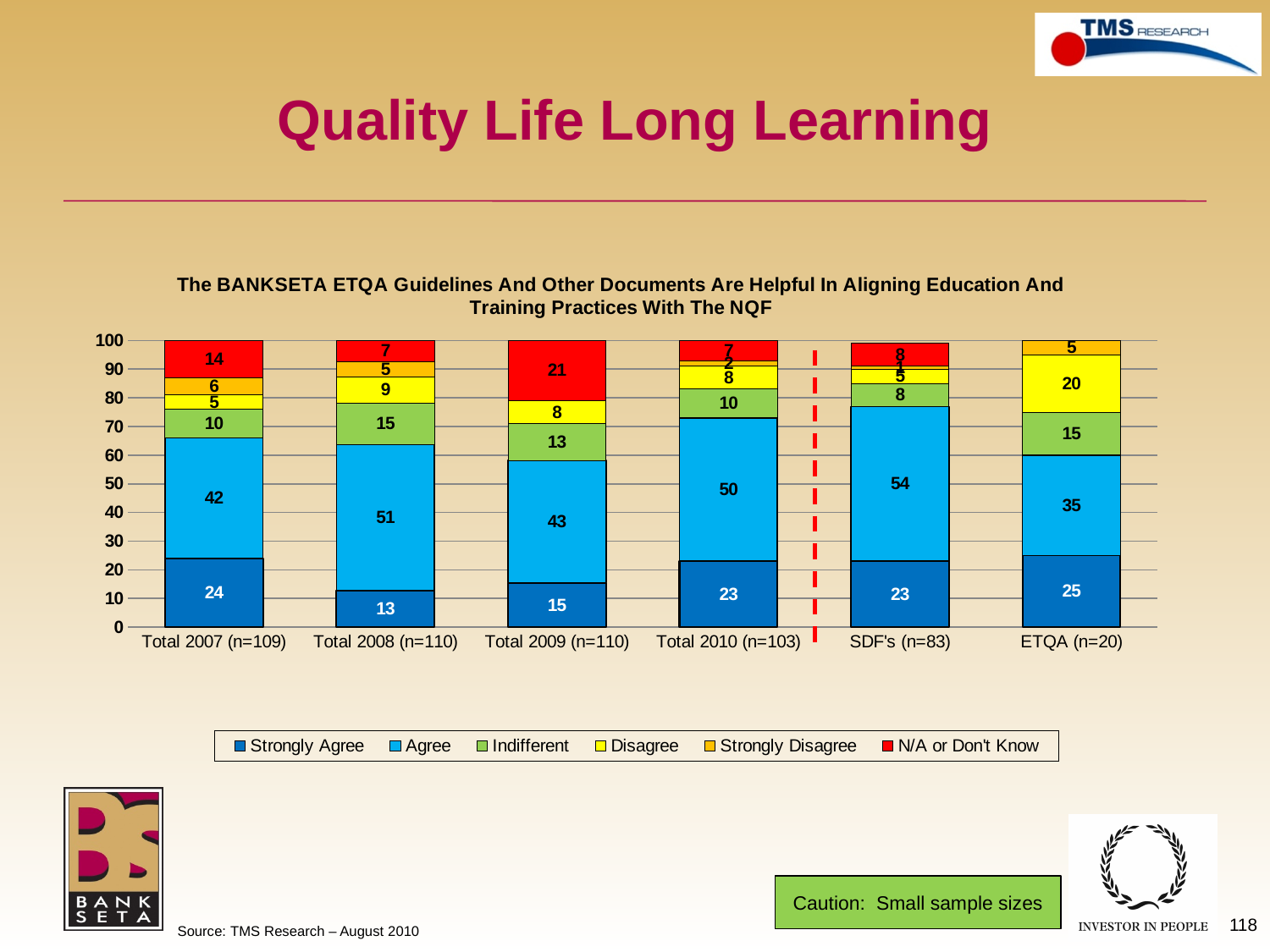
What is the difference between the Agree values for Total 2008 (n=110) and Total 2007 (n=109)? 9 What is the Indifferent value for Total 2008 (n=110)? 15 How many categories are shown on the x axis? 6 Which has a larger Disagree value, ETQA (n=20) or Total 2008 (n=110)? ETQA (n=20) Which category has the highest Agree value? SDF's (n=83) What is the Strongly Agree value for ETQA (n=20)? 25 How many series does the legend list? 6 Does the Strongly Agree value rise or fall from Total 2008 (n=110) to Total 2010 (n=103)? Rises Which category has the lowest Strongly Agree value? Total 2008 (n=110) What is the N/A or Don't Know value for Total 2009 (n=110)? 21 What kind of chart is shown on the slide? Stacked bar chart What is the value for Agree in the SDF's (n=83) bar? 54